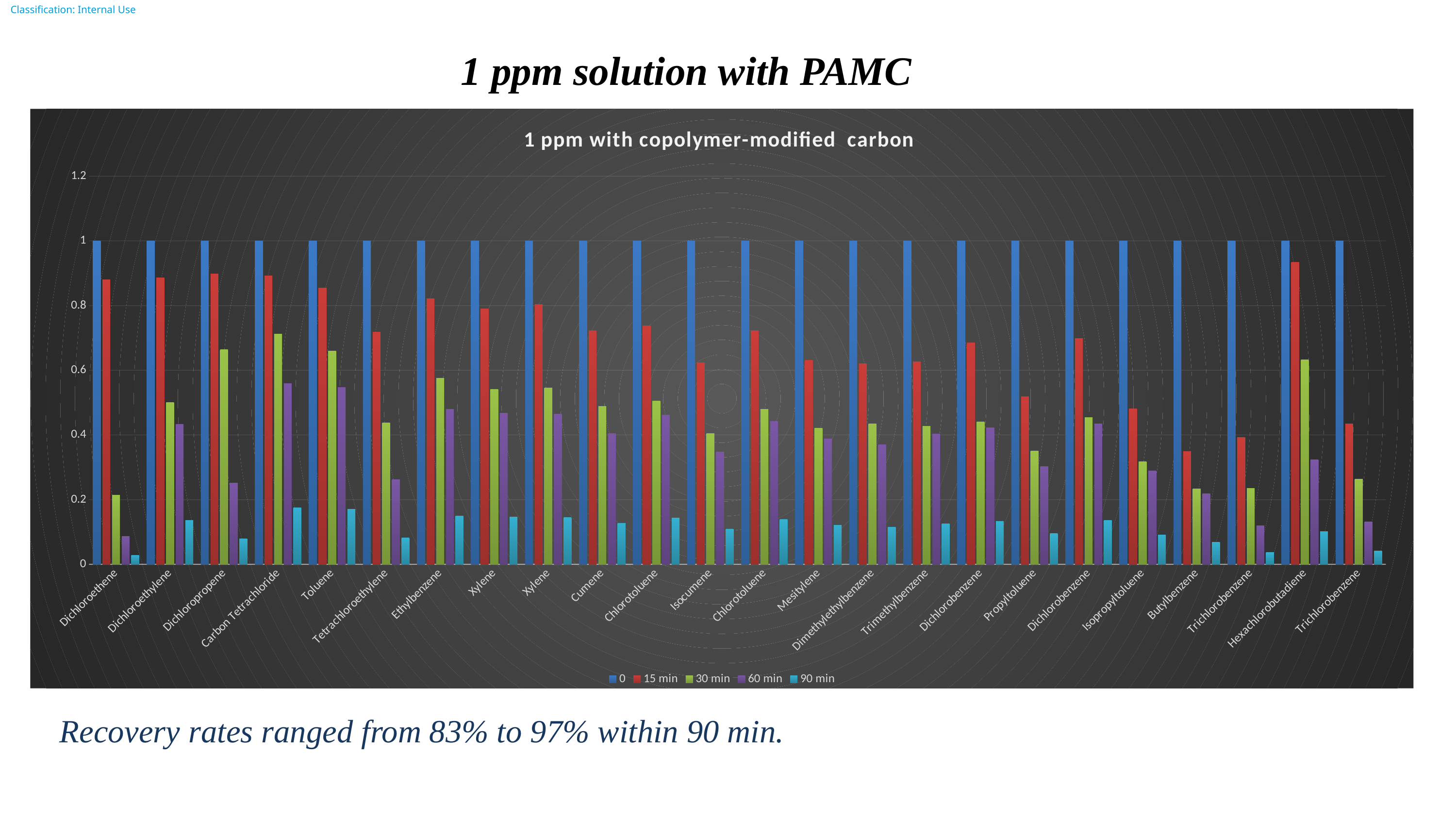
Is the 15 min value for Dichloroethene greater or less than 0.8? greater What is the value of the '0' series for Toluene? 1 For Dichloroethene, do the values rise or fall from the 0 series to the 90 min series? fall Which category has the highest 15 min value? Hexachlorobutadiene How many series does the chart legend list? 5 What kind of chart is shown on the slide? bar chart Is the 90 min value for Dichloroethene greater or less than 0.2? less Is the 30 min value for Carbon Tetrachloride greater or less than 0.6? greater How many categories are plotted along the x axis of the chart? 24 What is the title shown inside the chart area? 1 ppm with copolymer-modified carbon Which is larger, the 15 min value for Toluene or the 15 min value for Tetrachloroethylene? Toluene